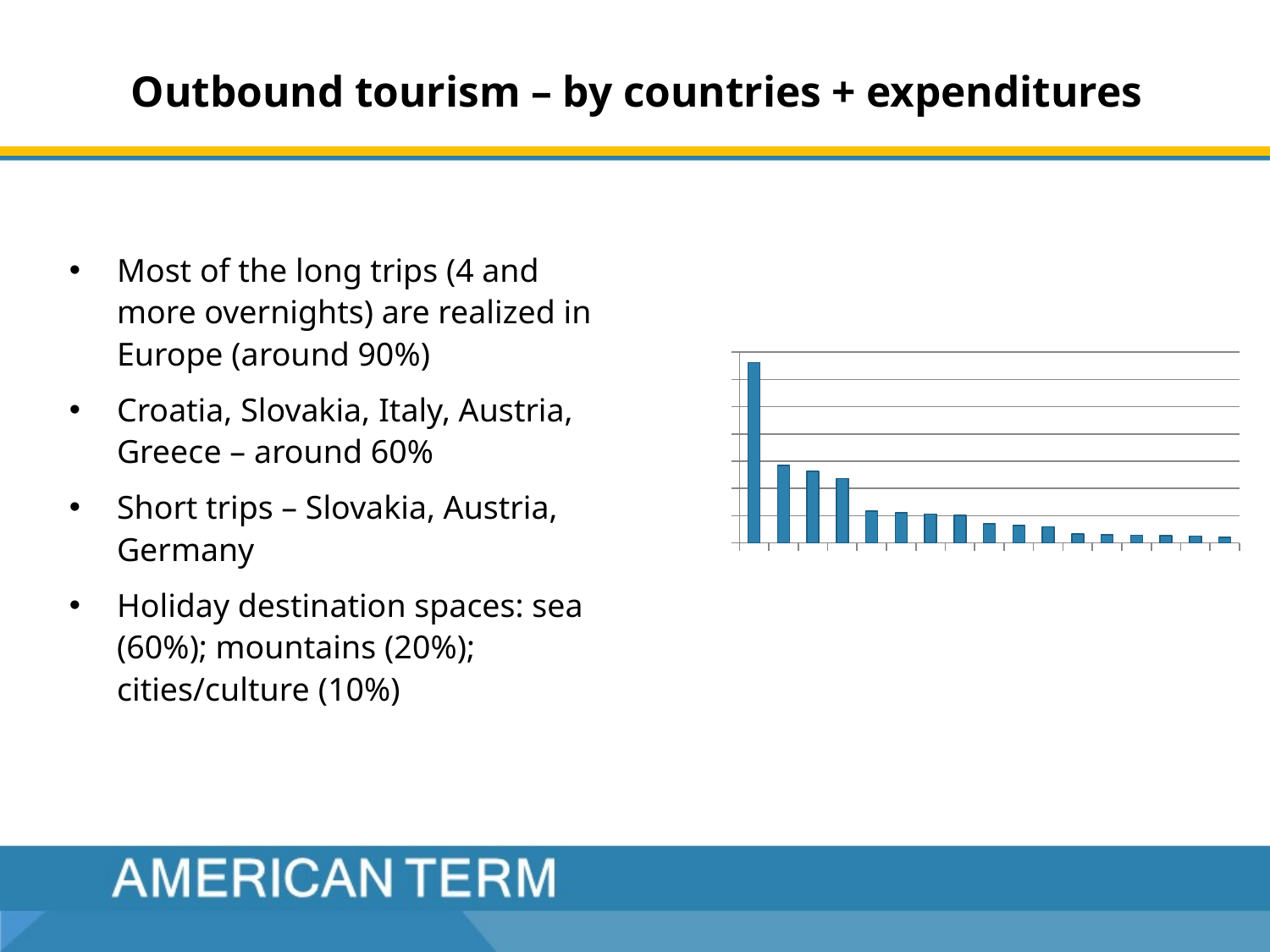
Do the bar values in the chart rise or fall from left to right? fall Is the fifth bar from the left taller or shorter than the fourth bar? shorter Which bar in the chart is the lowest? the rightmost (last) bar How many bars are plotted in the chart? 17 Which bar in the chart is the highest? the leftmost (first) bar Does the chart display a title or axis labels? no What kind of chart is shown on the right side of the slide? bar chart What colour are the bars in the chart? blue Is the first bar from the left taller or shorter than the second bar? taller